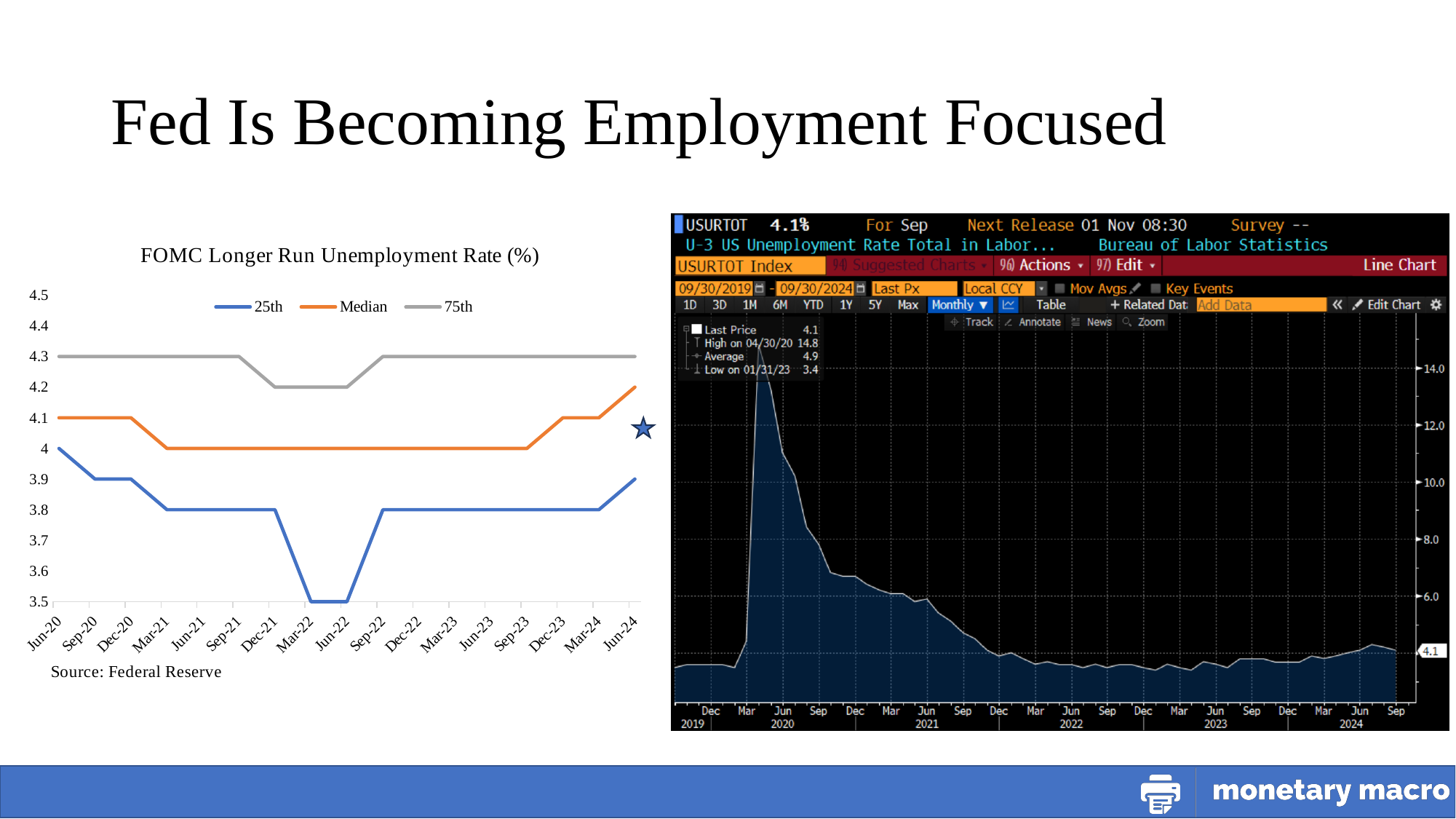
On the right chart (USURTOT Index), what is the Last Price shown? 4.1 On the right chart (USURTOT Index), what is the High value and on what date did it occur? 14.8 on 04/30/20 On the left chart, FOMC Longer Run Unemployment Rate (%), what is the Median value at Jun-24? 4.2 On the left chart, FOMC Longer Run Unemployment Rate (%), is the Median value at Jun-24 greater or less than the Median value at Sep-23? greater On the left chart, FOMC Longer Run Unemployment Rate (%), what is the difference between the 75th and 25th percentile values at Mar-22? 0.7 On the left chart, FOMC Longer Run Unemployment Rate (%), what is the 75th percentile value at Dec-21? 4.2 On the left chart, FOMC Longer Run Unemployment Rate (%), at which date does the 25th percentile series reach its lowest value? Mar-22 and Jun-22 On the left chart, FOMC Longer Run Unemployment Rate (%), what is the 25th percentile value at Mar-22? 3.5 On the left chart, FOMC Longer Run Unemployment Rate (%), how many series does the legend list? 3 On the left chart, FOMC Longer Run Unemployment Rate (%), what is the Median value at Jun-20? 4.1 On the left chart, FOMC Longer Run Unemployment Rate (%), what is the source cited below the chart? Federal Reserve On the left chart, FOMC Longer Run Unemployment Rate (%), what kind of chart is it? Line chart